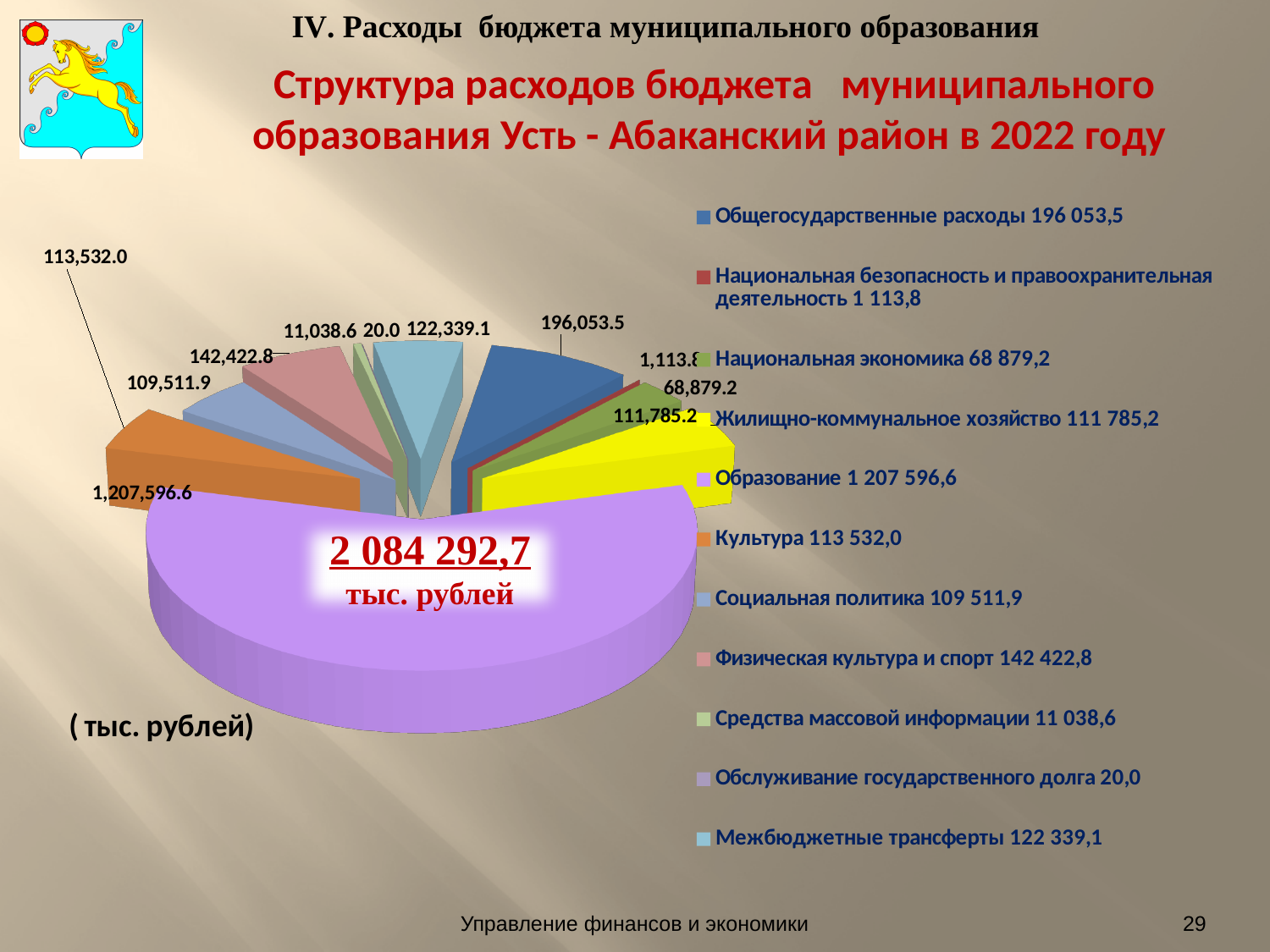
What total amount is printed in the centre of the pie chart? 2 084 292,7 тыс. рублей What is the value for Общегосударственные расходы according to the legend? 196 053,5 What is the value for Обслуживание государственного долга? 20,0 What unit is indicated below the pie chart? тыс. рублей What is the difference between Физическая культура и спорт (142 422,8) and Жилищно-коммунальное хозяйство (111 785,2)? 30 637,6 What kind of chart is shown on the slide? Pie chart What is the value for Образование according to the legend? 1 207 596,6 What is the value for Межбюджетные трансферты according to the legend? 122 339,1 How many categories does the pie chart have? 11 Which category has the smallest value? Обслуживание государственного долга Which is larger, Культура or Социальная политика? Культура Which category has the largest share of the pie? Образование